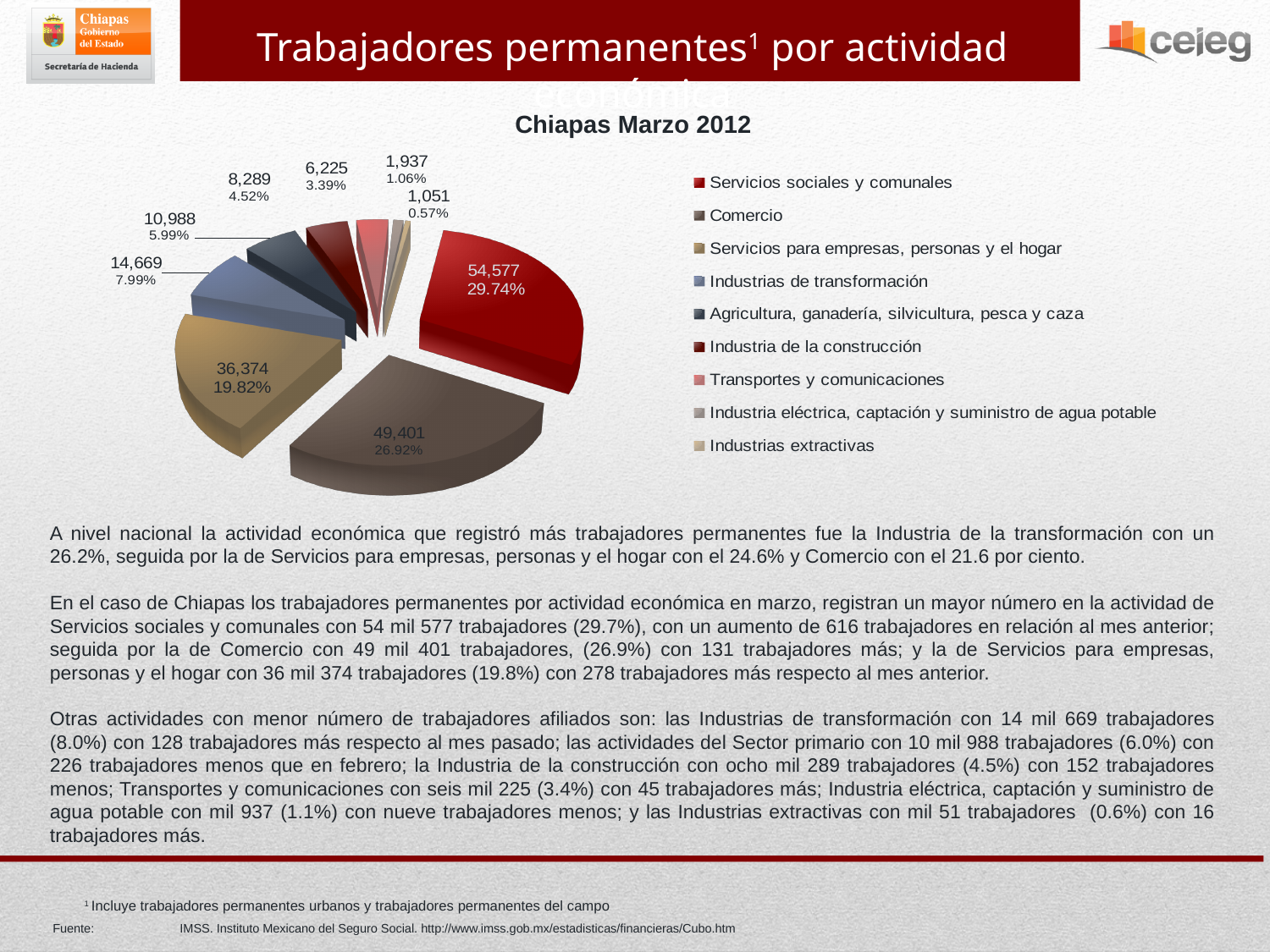
What percentage share is shown for Comercio? 26.92% Which is larger, the value for Industria de la construcción or the value for Transportes y comunicaciones? Industria de la construcción How many categories does the legend of the pie chart list? 9 What is the title shown above the pie chart? Chiapas Marzo 2012 Which category has the smallest slice of the pie? Industrias extractivas What is the difference between the values for Servicios sociales y comunales and Comercio? 5,176 What percentage share is shown for Industrias de transformación? 7.99% What is the value shown for Servicios para empresas, personas y el hogar? 36,374 What kind of chart is shown on the slide? Pie chart What is the value shown for Industria eléctrica, captación y suministro de agua potable? 1,937 Which category has the largest slice of the pie? Servicios sociales y comunales What is the value shown for Servicios sociales y comunales? 54,577